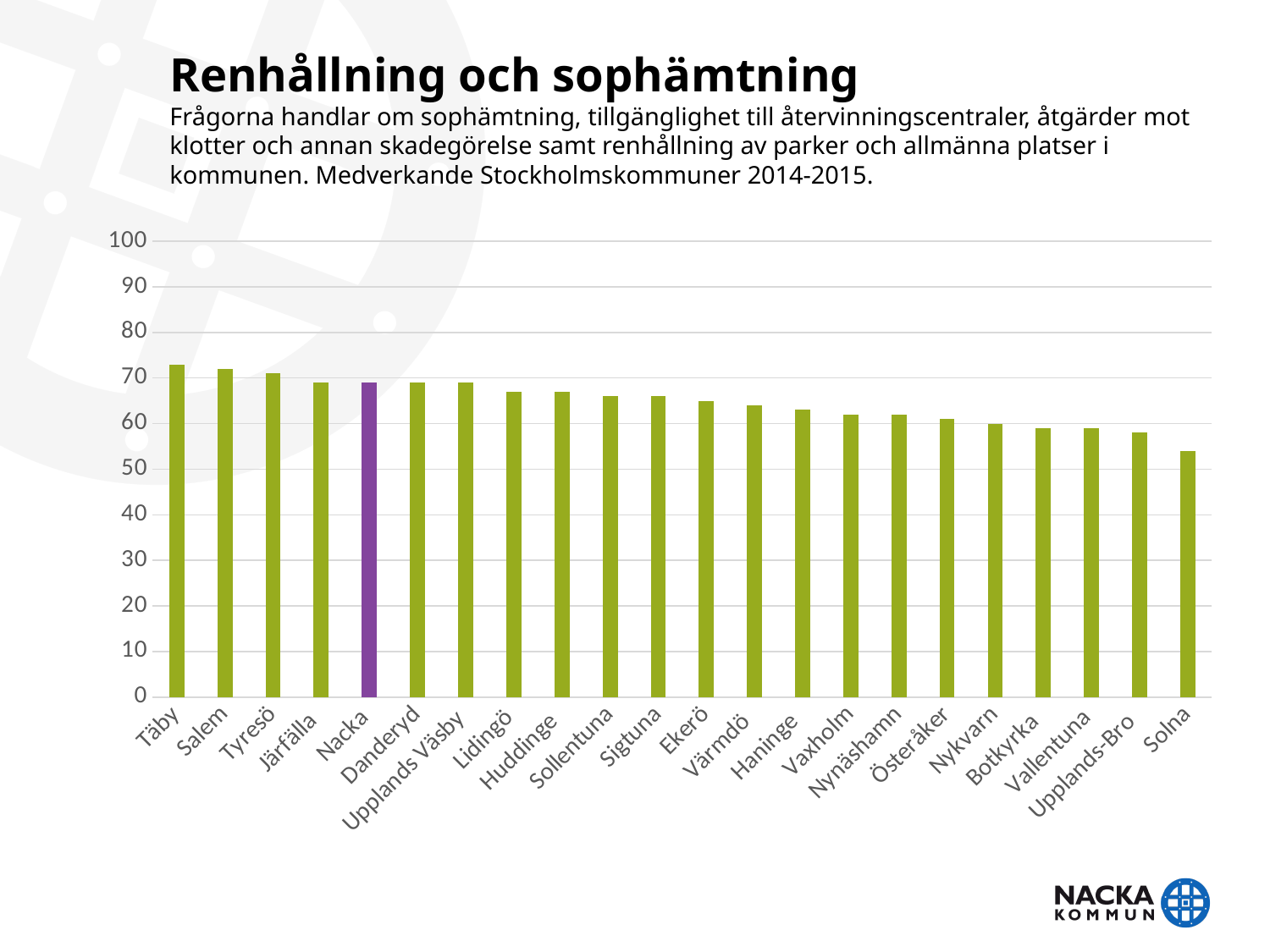
Is the value for Upplands-Bro greater or less than 60? less Which municipality has the highest value in the chart? Täby Do the values rise or fall from left to right along the x axis? fall What kind of chart is shown on the slide? bar chart How many municipalities are shown on the x axis of the chart? 22 Is the value for Täby greater or less than 70? greater Is the value for Ekerö greater or less than 70? less Which has a larger value, Nacka or Solna? Nacka Which municipality's bar is shown in purple instead of green? Nacka Which municipality has the lowest value in the chart? Solna